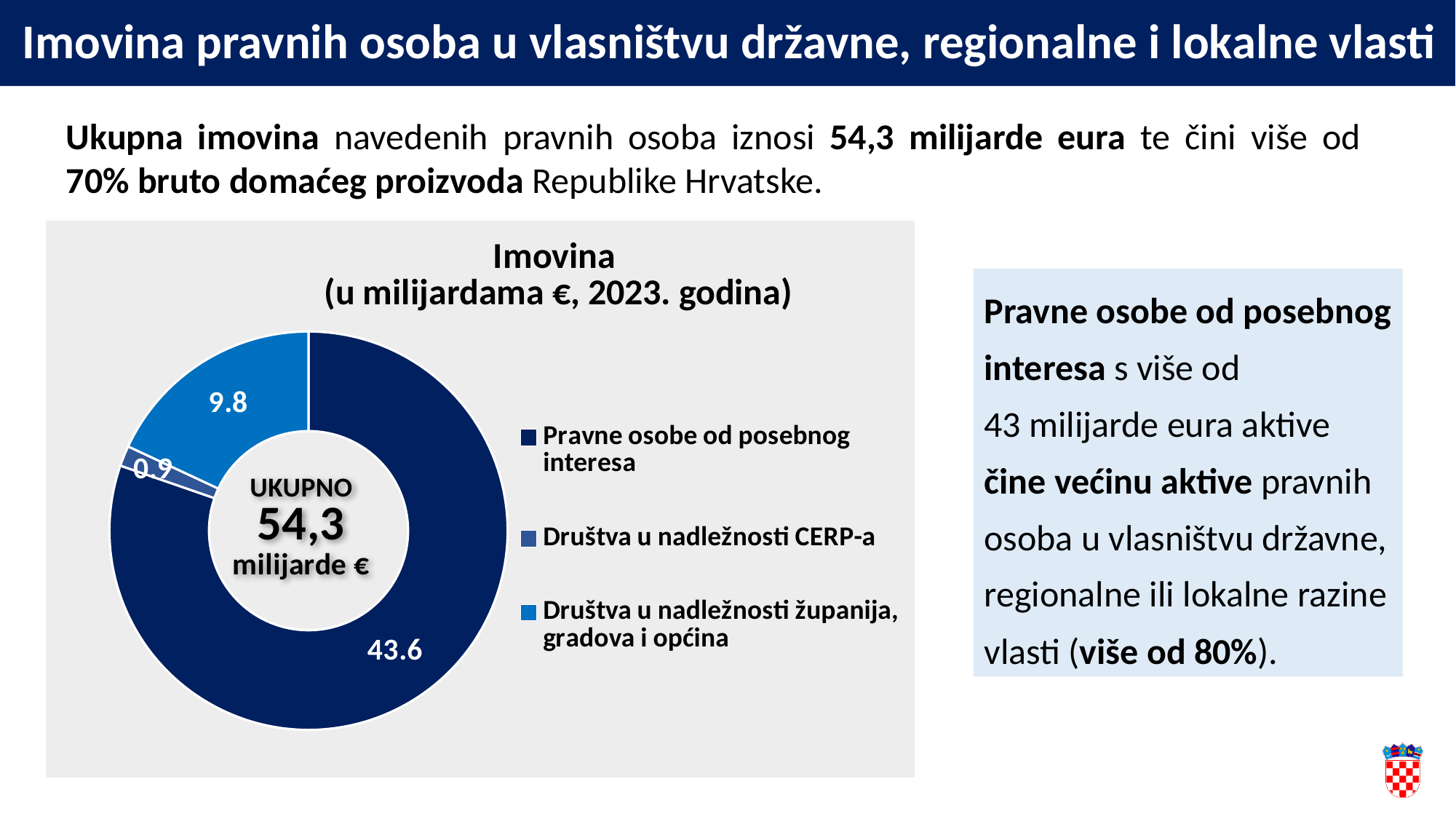
What is the value for 'Društva u nadležnosti županija, gradova i općina' in the chart? 9.8 What is the value for 'Pravne osobe od posebnog interesa' in the chart? 43.6 What is the value for 'Društva u nadležnosti CERP-a' in the chart? 0.9 Which category has the largest slice in the chart? Pravne osobe od posebnog interesa What is the title of the chart? Imovina (u milijardama €, 2023. godina) What is the difference between the values for 'Društva u nadležnosti županija, gradova i općina' and 'Društva u nadležnosti CERP-a'? 8.9 Which is larger: the value for 'Društva u nadležnosti županija, gradova i općina' or the value for 'Društva u nadležnosti CERP-a'? Društva u nadležnosti županija, gradova i općina What is the difference between the values for 'Pravne osobe od posebnog interesa' and 'Društva u nadležnosti županija, gradova i općina'? 33.8 What total is shown in the centre of the chart? 54,3 milijarde € What type of chart is shown on the slide? Pie chart (donut) Which category has the smallest slice in the chart? Društva u nadležnosti CERP-a How many categories does the chart show? 3